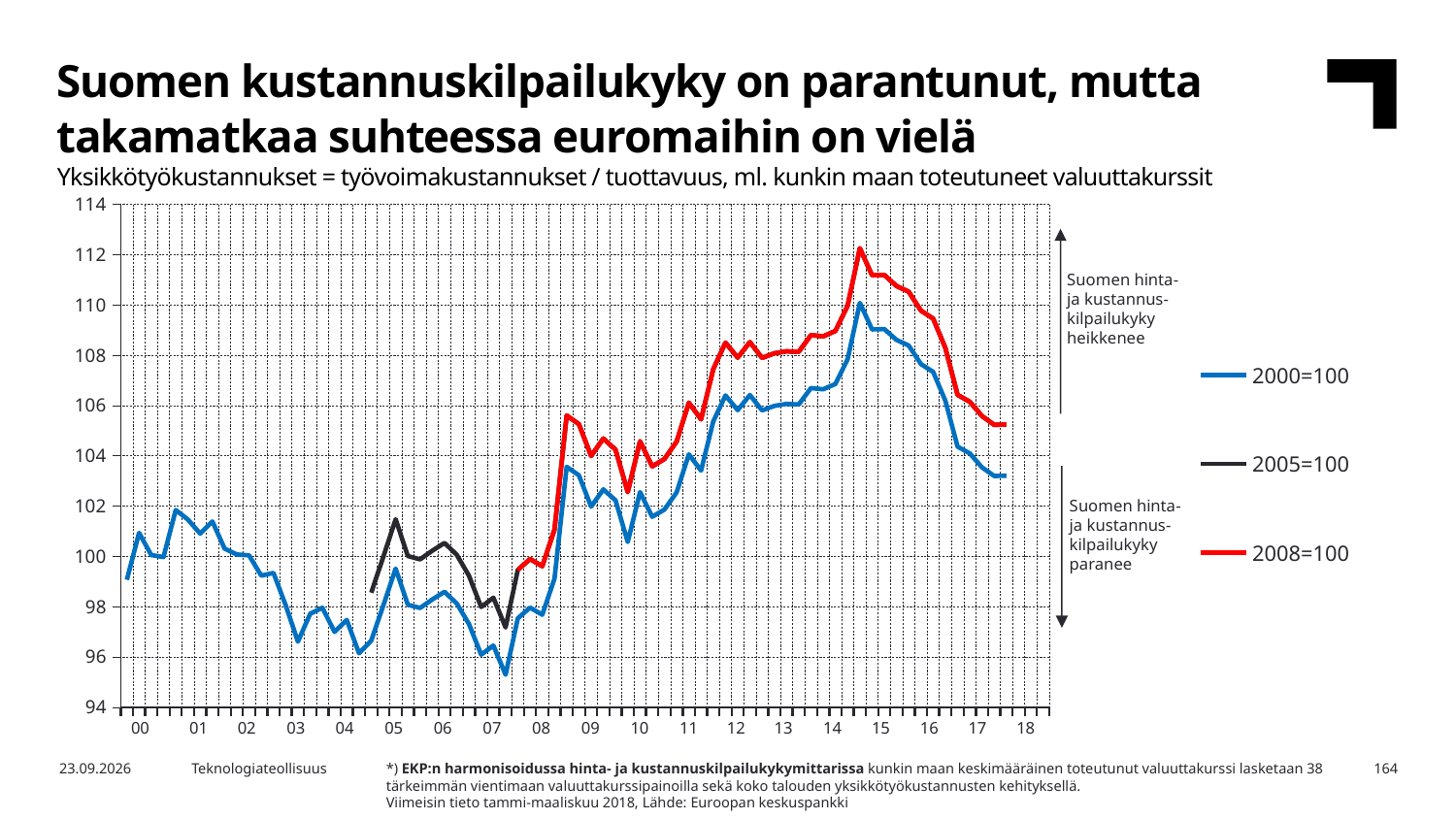
Is the lowest value of the 2000=100 series around 2007 greater or less than 98? less How many series does the legend list? 3 What kind of chart is shown on the slide? line chart Does the 2000=100 series rise or fall between 2015 and 2018? fall Which series is drawn in black? 2005=100 Is the peak value of the 2000=100 series around 2014 greater or less than 108? greater Does the 2000=100 series rise or fall between 2008 and 2014? rise How many year labels are shown on the x axis? 19 Which series reaches the highest value on the chart? 2008=100 Is the peak value of the 2008=100 series around 2014 greater or less than 110? greater At the end of the chart (around 2017–18), which series is higher: 2000=100 or 2008=100? 2008=100 Which series is drawn in red? 2008=100